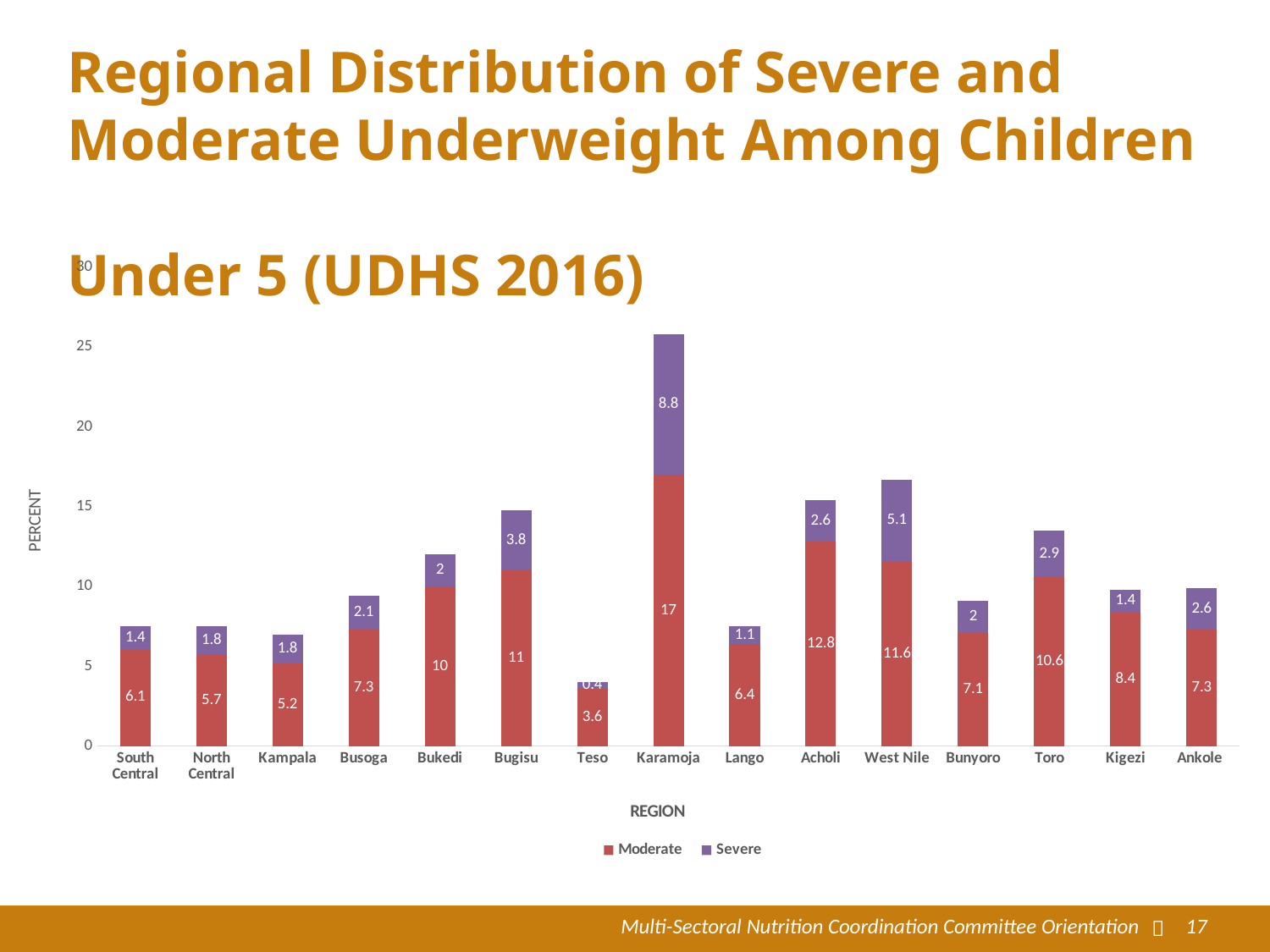
What is the Moderate underweight value for Acholi? 12.8 What kind of chart is shown on the slide? Stacked bar chart What is the difference between the Moderate values for Bugisu and Bukedi? 1 What is the Moderate underweight value for Karamoja? 17 Which region has the highest Moderate underweight value? Karamoja What is the Severe underweight value for West Nile? 5.1 Is the total stacked bar for Karamoja greater or less than 25? greater How many series does the legend list? 2 Which region has the lowest Moderate underweight value? Teso Which is larger, the Severe value for Toro or the Severe value for Acholi? Toro What is the total (Moderate plus Severe) for Karamoja? 25.8 How many regions are shown on the x axis? 15